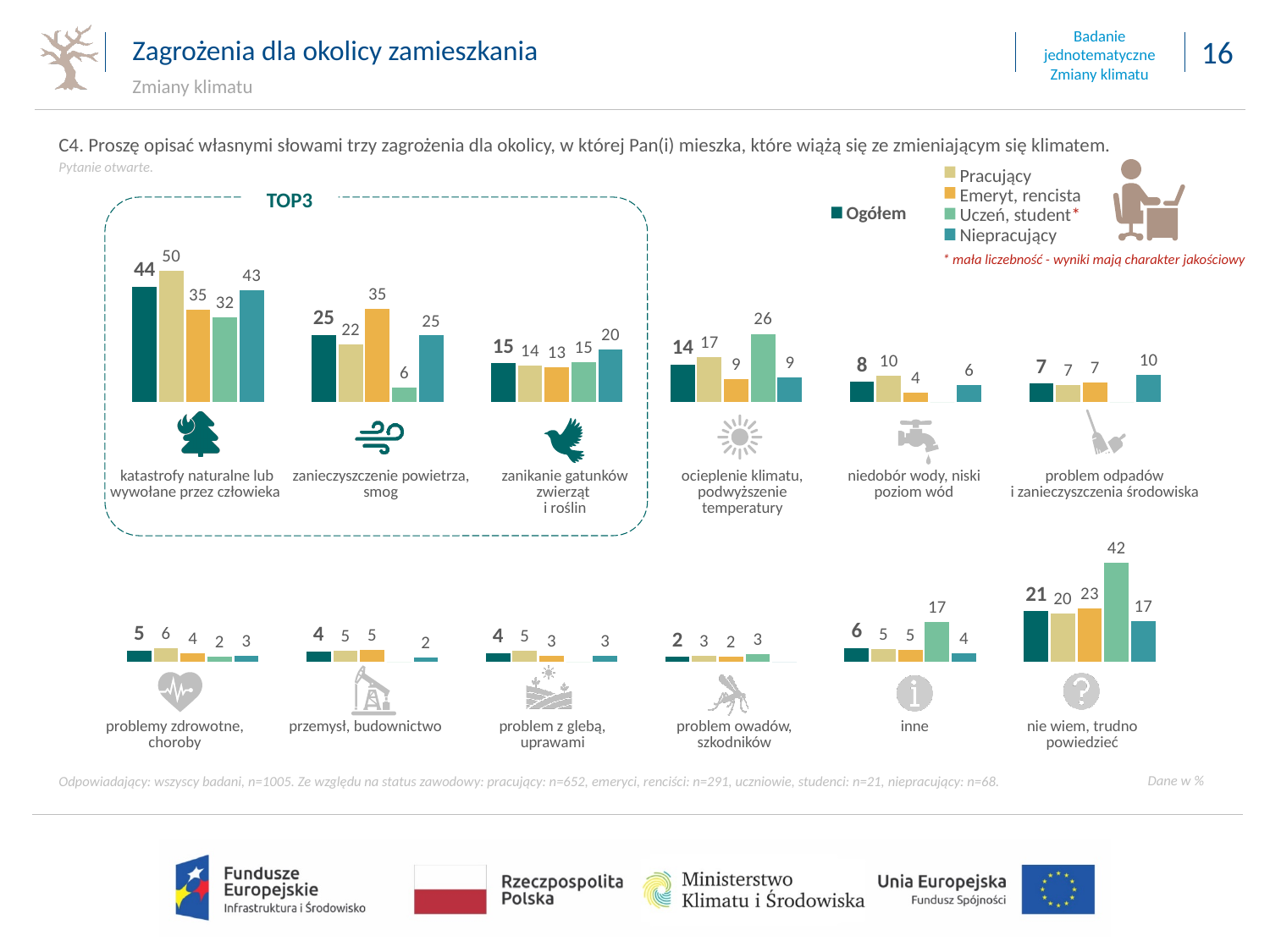
In the chart for 'ocieplenie klimatu, podwyższenie temperatury', what is the value for Uczeń, student? 26 In the chart for 'zanieczyszczenie powietrza, smog', which group has the lowest value? Uczeń, student How many series does the legend list? 5 Which three categories are grouped inside the dashed 'TOP3' box? katastrofy naturalne lub wywołane przez człowieka; zanieczyszczenie powietrza, smog; zanikanie gatunków zwierząt i roślin In the chart for 'katastrofy naturalne lub wywołane przez człowieka', what is the difference between the Pracujący value and the Uczeń, student value? 18 In the chart for 'zanieczyszczenie powietrza, smog', what is the value for Emeryt, rencista? 35 In the chart for 'problem odpadów i zanieczyszczenia środowiska', what is the value for Niepracujący? 10 What kind of chart is used to show the results for each threat category? Bar chart In the chart for 'zanikanie gatunków zwierząt i roślin', which is larger: the value for Niepracujący or the value for Pracujący? Niepracujący In the chart for 'nie wiem, trudno powiedzieć', which group has the highest value? Uczeń, student In the chart for 'katastrofy naturalne lub wywołane przez człowieka', what is the value for Ogółem? 44 In the chart for 'inne', what is the value for Uczeń, student? 17